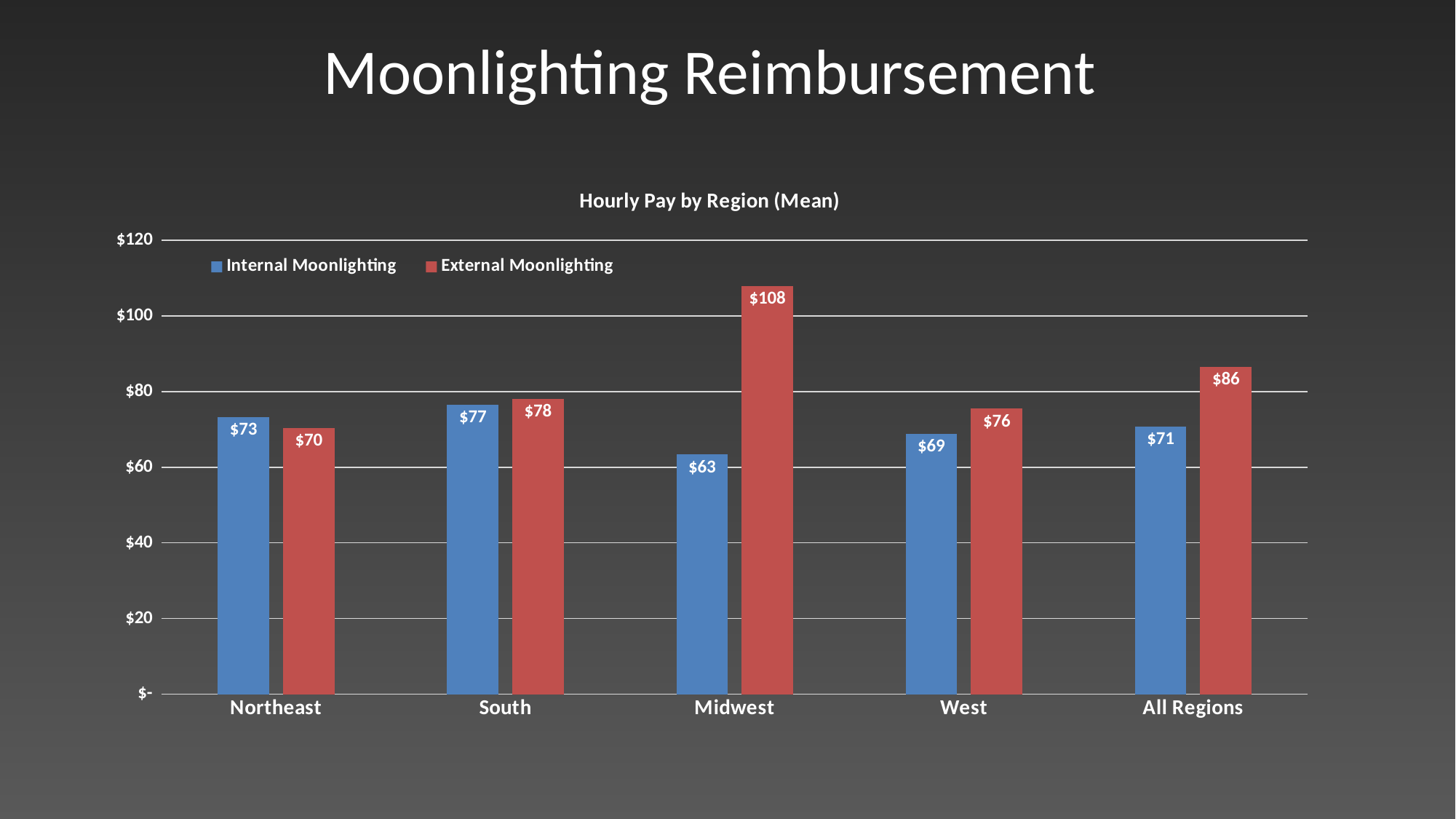
What is the title of the chart? Hourly Pay by Region (Mean) What is the Internal Moonlighting hourly pay for the South? $77 How many regions are shown on the x axis? 5 Which is larger in the Northeast, Internal Moonlighting or External Moonlighting hourly pay? Internal Moonlighting What is the External Moonlighting hourly pay for All Regions? $86 Which region has the lowest Internal Moonlighting hourly pay? Midwest What is the difference between External and Internal Moonlighting hourly pay in the Midwest? $45 Is the External Moonlighting hourly pay for the Midwest greater or less than $100? greater What is the Internal Moonlighting hourly pay for the Midwest? $63 Which region has the highest External Moonlighting hourly pay? Midwest How many series does the legend list? 2 What kind of chart is shown on the slide? Bar chart